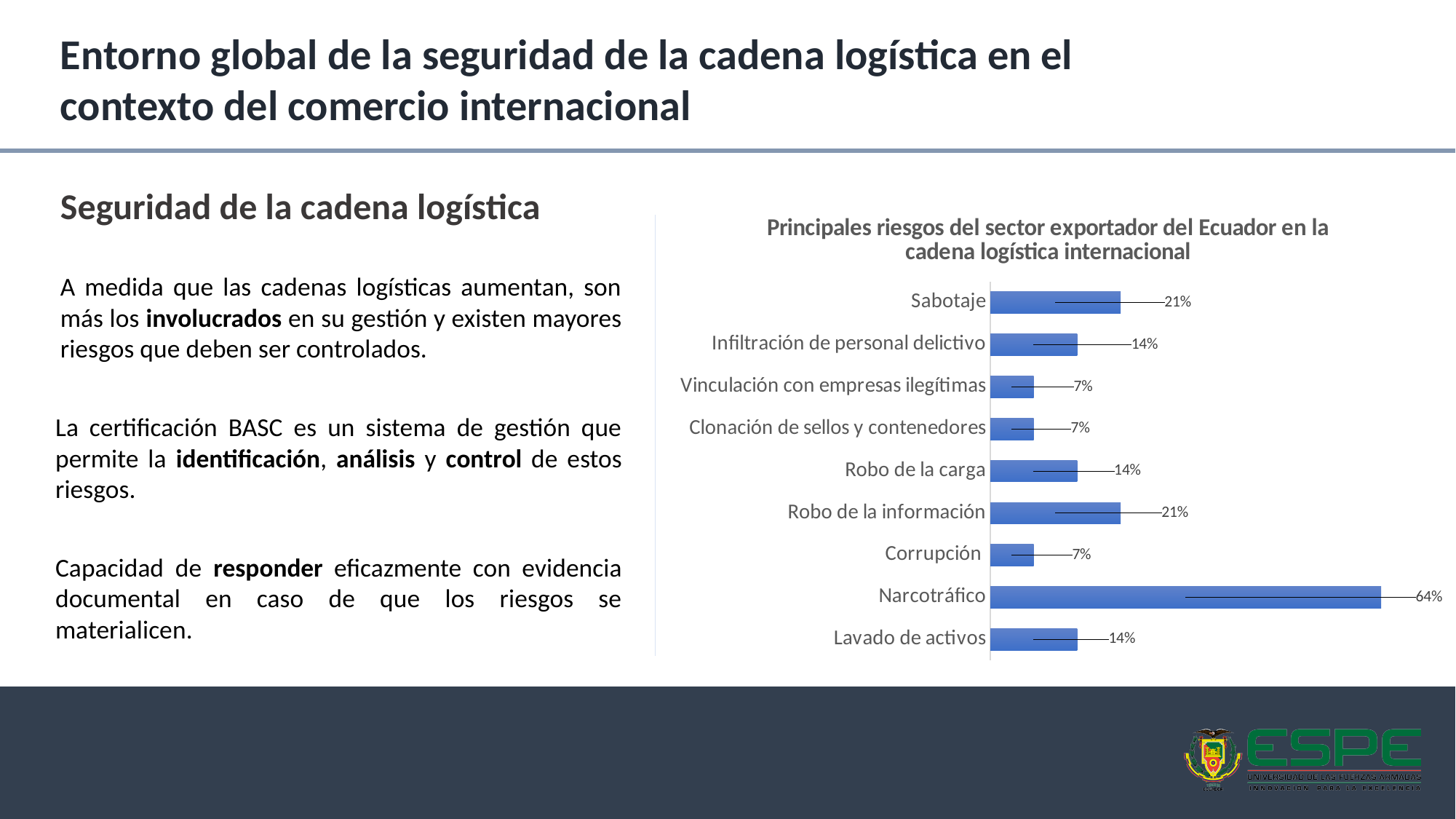
What is the value for Sabotaje? 21% What kind of chart is shown on the slide? Bar chart What is the difference between the values for Narcotráfico and Robo de la información? 43% What is the value for Corrupción? 7% Which is larger, the value for Robo de la carga or the value for Clonación de sellos y contenedores? Robo de la carga What is the title of the chart? Principales riesgos del sector exportador del Ecuador en la cadena logística internacional Which category has the highest value? Narcotráfico How many categories are shown in the chart? 9 What is the difference between the values for Sabotaje and Lavado de activos? 7% What colour are the bars in the chart? Blue What is the value for Infiltración de personal delictivo? 14% What is the value for Narcotráfico? 64%